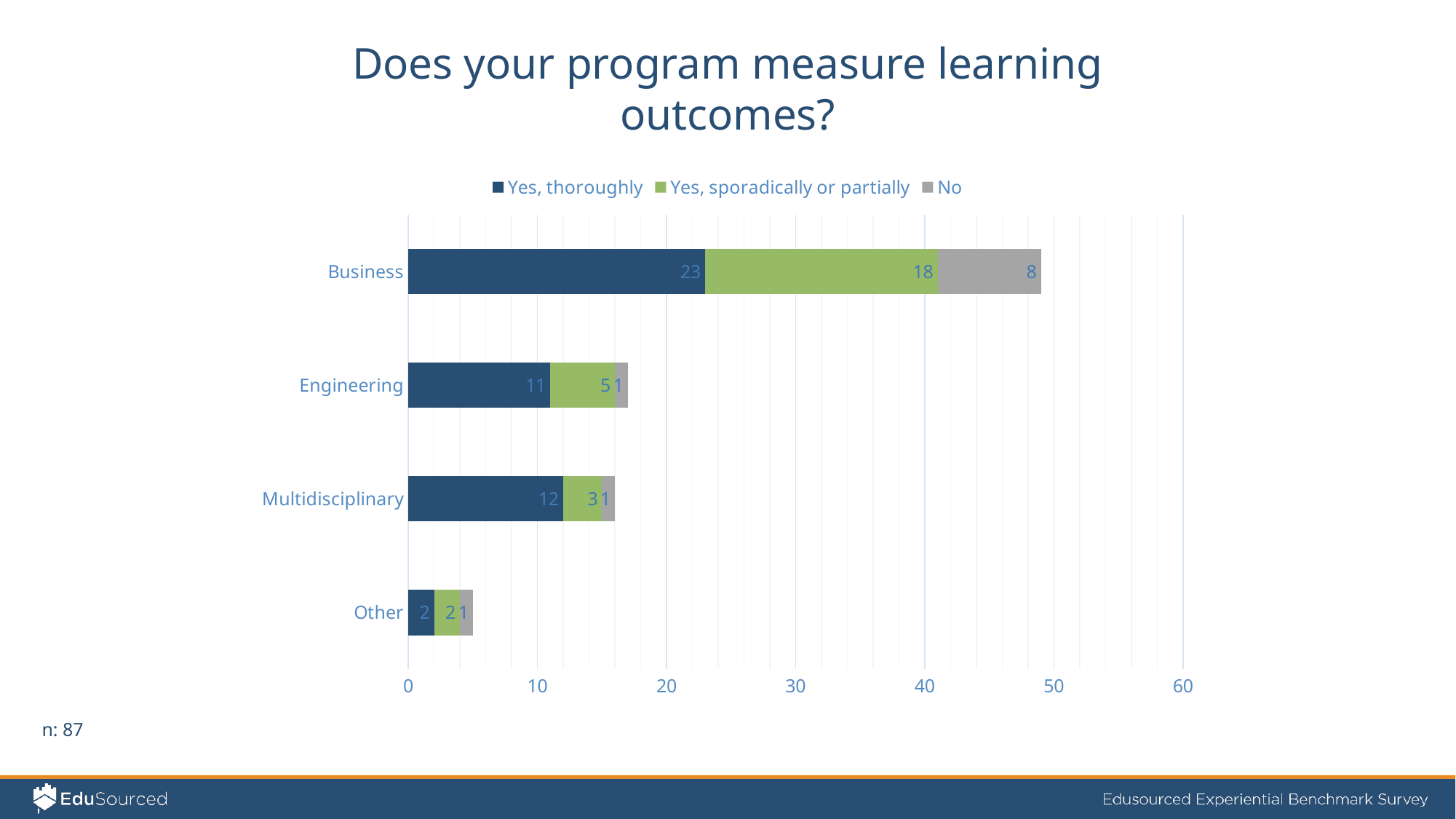
What is the total of the stacked bar for Engineering? 17 What is the value for "Yes, sporadically or partially" for Engineering? 5 What is the value for "Yes, thoroughly" for Business? 23 Which is larger: the "Yes, thoroughly" value for Engineering or for Multidisciplinary? Multidisciplinary What is the difference between the "Yes, thoroughly" values for Business and Engineering? 12 How many series does the legend list? 3 What is the value for "No" for Business? 8 Which category has the lowest value for "Yes, sporadically or partially"? Other How many categories are shown on the chart? 4 What is the value for "Yes, thoroughly" for Multidisciplinary? 12 Which category has the highest value for "Yes, thoroughly"? Business What is the total of the stacked bar for Business? 49